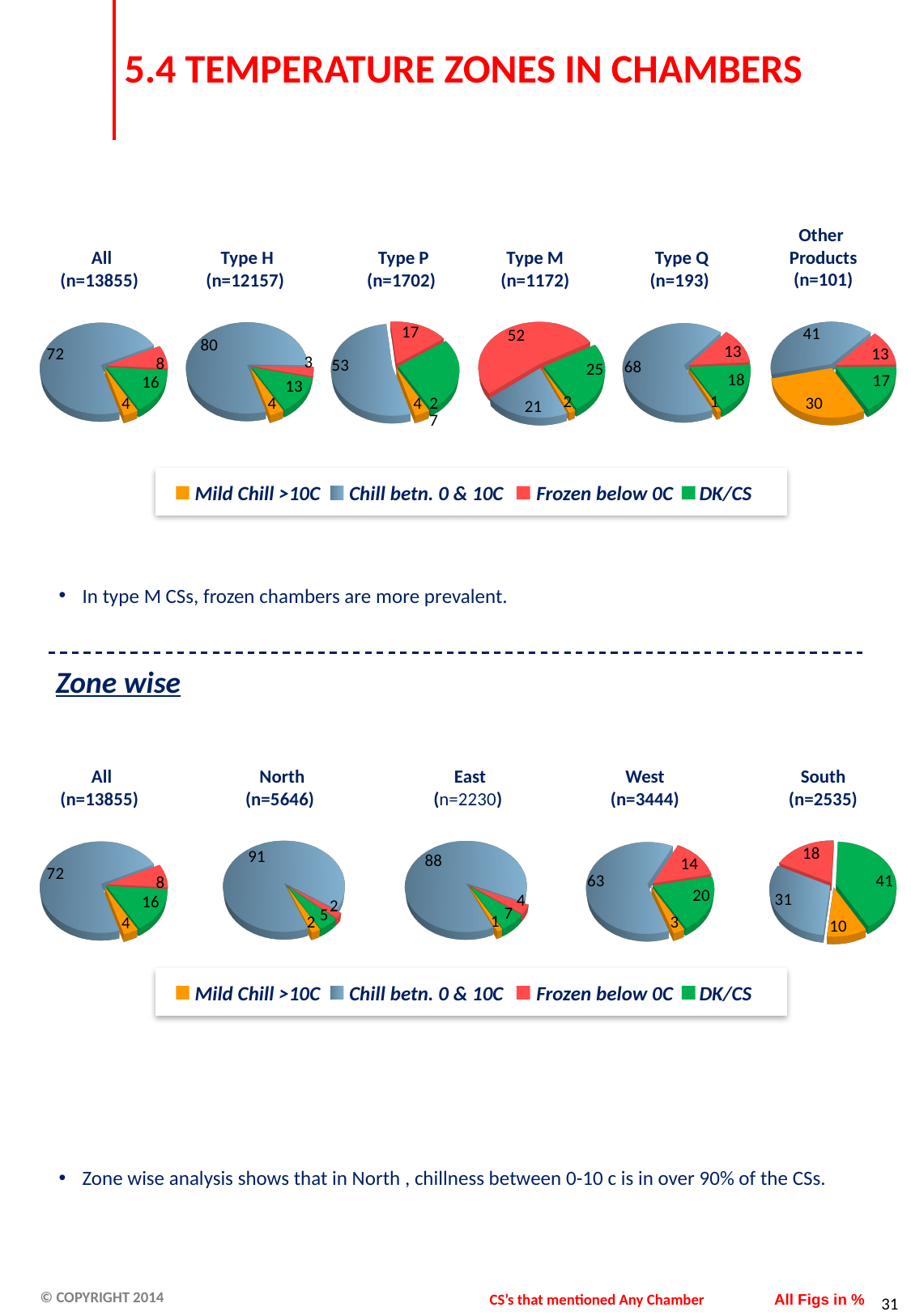
In the Type M (n=1172) pie chart, what is the value for Frozen below 0C? 52 How many pie charts are shown in the Zone wise section of the slide? 5 Which colour represents Frozen below 0C in the legend? Red How many series does the legend of the Zone wise pie charts list? 4 In the Other Products (n=101) pie chart, what is the value for Mild Chill >10C? 30 In the West (n=3444) pie chart, what is the difference between the DK/CS value and the Frozen below 0C value? 6 What kind of chart is used to show the temperature zones for each type and zone on this slide? Pie chart In the Type Q (n=193) pie chart, which category has the smallest share? Mild Chill >10C In the South (n=2535) pie chart, which category has the largest share? DK/CS In the Type H (n=12157) pie chart, which is larger: DK/CS or Frozen below 0C? DK/CS In the East (n=2230) pie chart, what is the value for DK/CS? 7 In the North (n=5646) pie chart, what is the value for Chill betn. 0 & 10C? 91